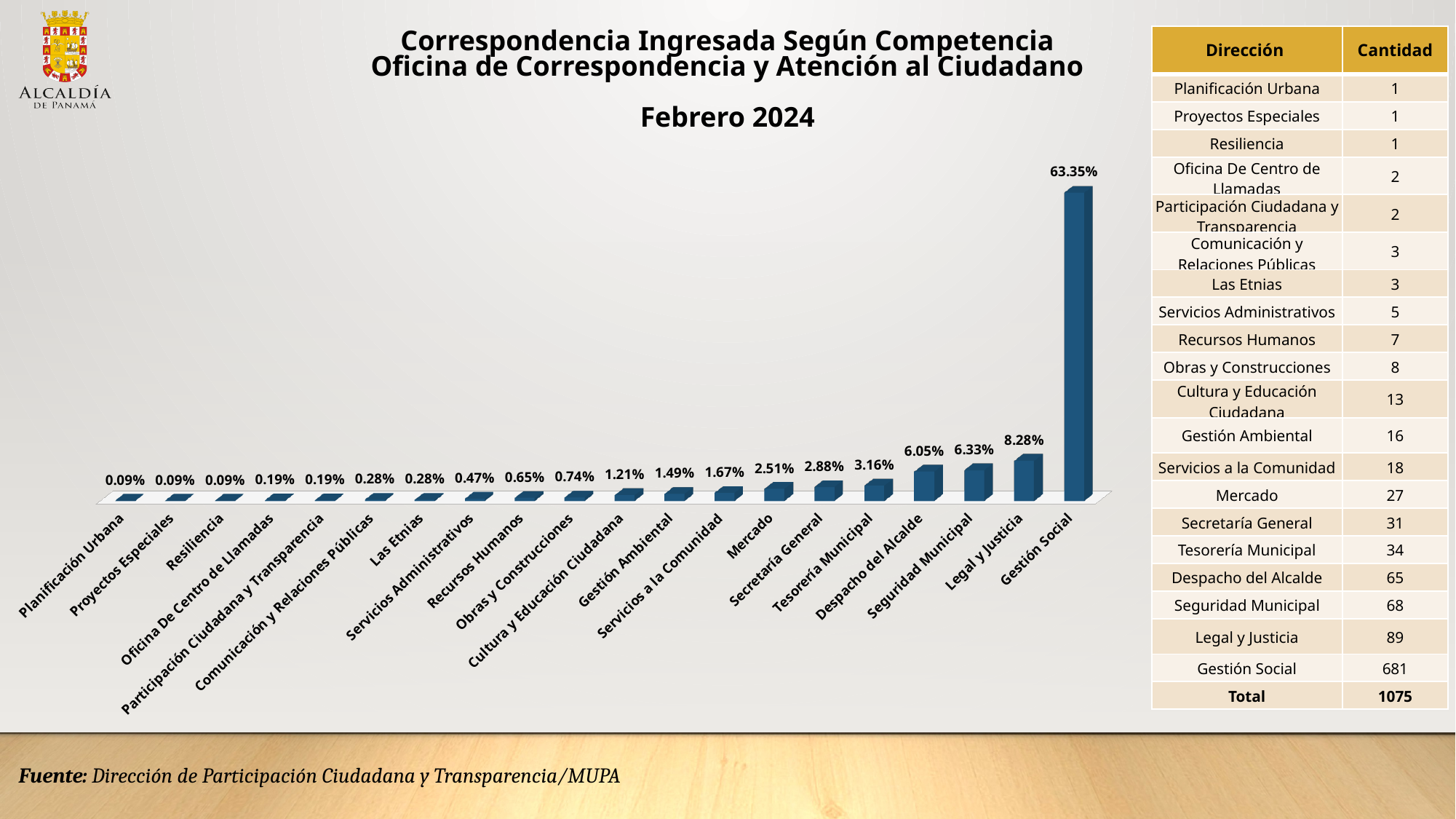
What is the value for Legal y Justicia? 8.28% What is the difference between the values for Seguridad Municipal and Despacho del Alcalde? 0.28% Which is larger, the value for Tesorería Municipal or the value for Secretaría General? Tesorería Municipal How many categories are shown on the chart? 20 What kind of chart is shown on the slide? Bar chart What is the value for Servicios Administrativos? 0.47% What is the value for Mercado? 2.51% Which category has the highest value? Gestión Social Do the values rise or fall from left to right along the x axis? Rise What is the difference between the values for Gestión Social and Legal y Justicia? 55.07% Which is larger, the value for Gestión Ambiental or the value for Obras y Construcciones? Gestión Ambiental What is the value for Gestión Social? 63.35%